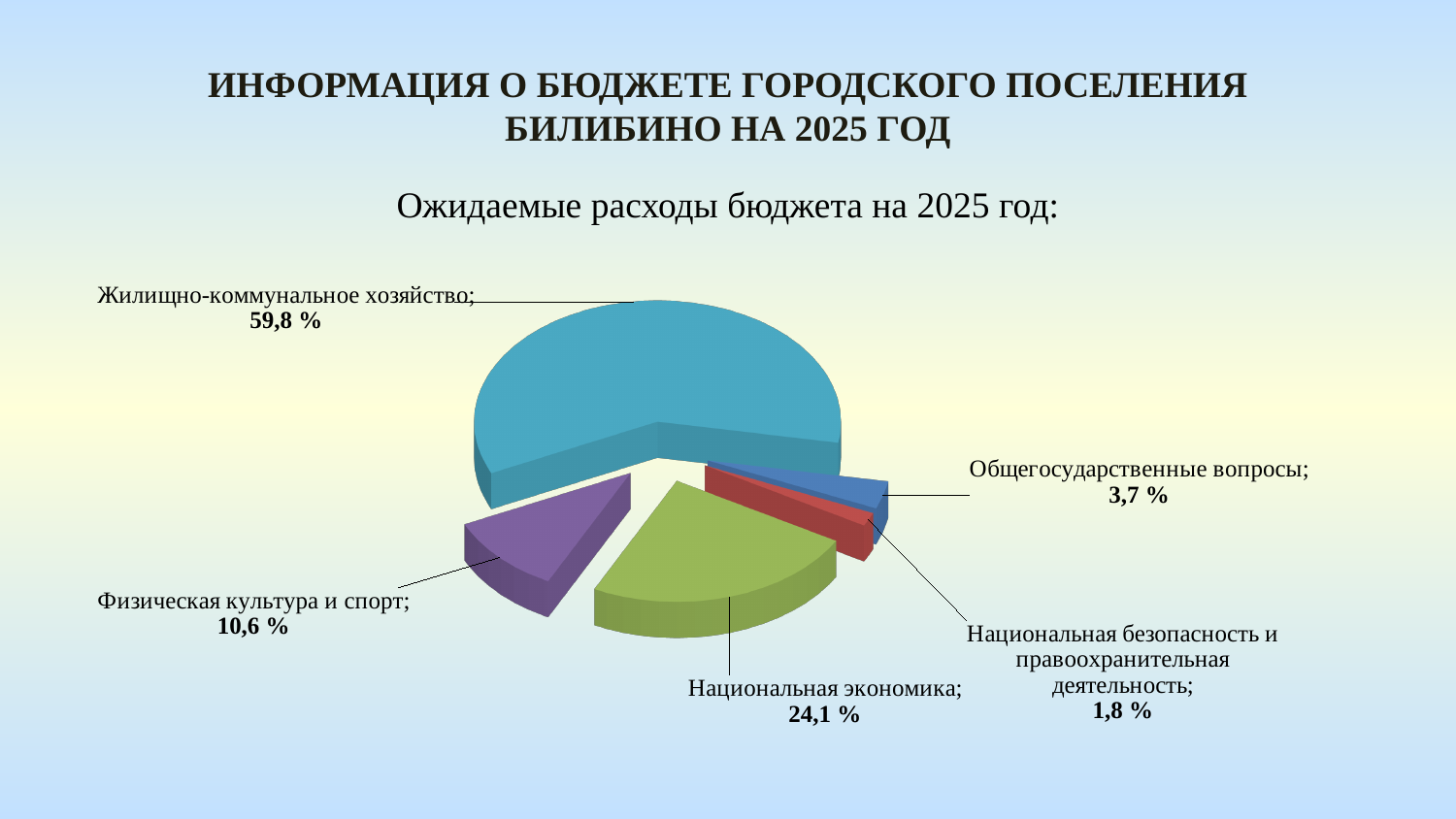
What is the value for Общегосударственные вопросы? 3,7 % What is the difference in percentage points between Жилищно-коммунальное хозяйство and Национальная экономика? 35,7 How many categories (slices) does the pie chart have? 5 What share is shown for Национальная безопасность и правоохранительная деятельность? 1,8 % Which is larger: the share for Физическая культура и спорт or the share for Общегосударственные вопросы? Физическая культура и спорт What share of expected 2025 budget expenditures goes to Жилищно-коммунальное хозяйство? 59,8 % What kind of chart is shown on the slide? pie chart What is the value shown for Национальная экономика? 24,1 % Which category has the largest share of the pie? Жилищно-коммунальное хозяйство What is the subtitle printed above the chart? Ожидаемые расходы бюджета на 2025 год: What percentage is shown for Физическая культура и спорт? 10,6 % Which category has the smallest share of the pie? Национальная безопасность и правоохранительная деятельность